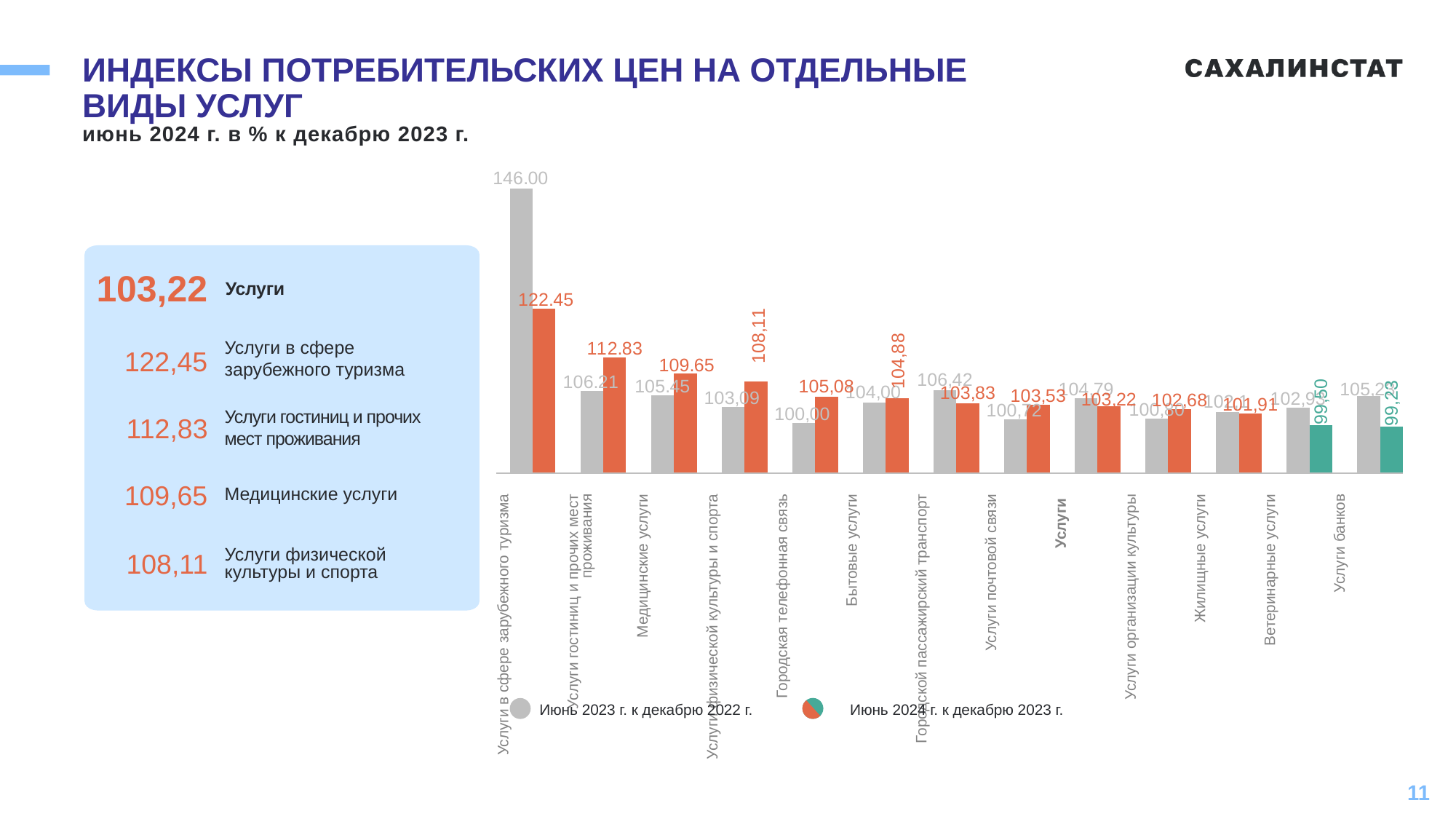
What is the value for Услуги в сфере зарубежного туризма in the series Июнь 2023 г. к декабрю 2022 г.? 146.00 Which category has the lowest value in the series Июнь 2024 г. к декабрю 2023 г.? Услуги банков How many series does the chart legend list? 2 What are the two series named in the chart legend? Июнь 2023 г. к декабрю 2022 г. and Июнь 2024 г. к декабрю 2023 г. Which category has the highest value in the series Июнь 2024 г. к декабрю 2023 г.? Услуги в сфере зарубежного туризма For Услуги гостиниц и прочих мест проживания, which series has the larger value: Июнь 2023 г. к декабрю 2022 г. or Июнь 2024 г. к декабрю 2023 г.? Июнь 2024 г. к декабрю 2023 г. What is the value for Услуги в сфере зарубежного туризма in the series Июнь 2024 г. к декабрю 2023 г.? 122.45 What is the value for Медицинские услуги in the series Июнь 2024 г. к декабрю 2023 г.? 109.65 What is the value for Услуги in the series Июнь 2024 г. к декабрю 2023 г.? 103,22 What kind of chart is shown on the slide? bar chart For Услуги в сфере зарубежного туризма, what is the difference between the Июнь 2023 г. к декабрю 2022 г. value and the Июнь 2024 г. к декабрю 2023 г. value? 23.55 How many service categories are plotted along the x axis of the chart? 13